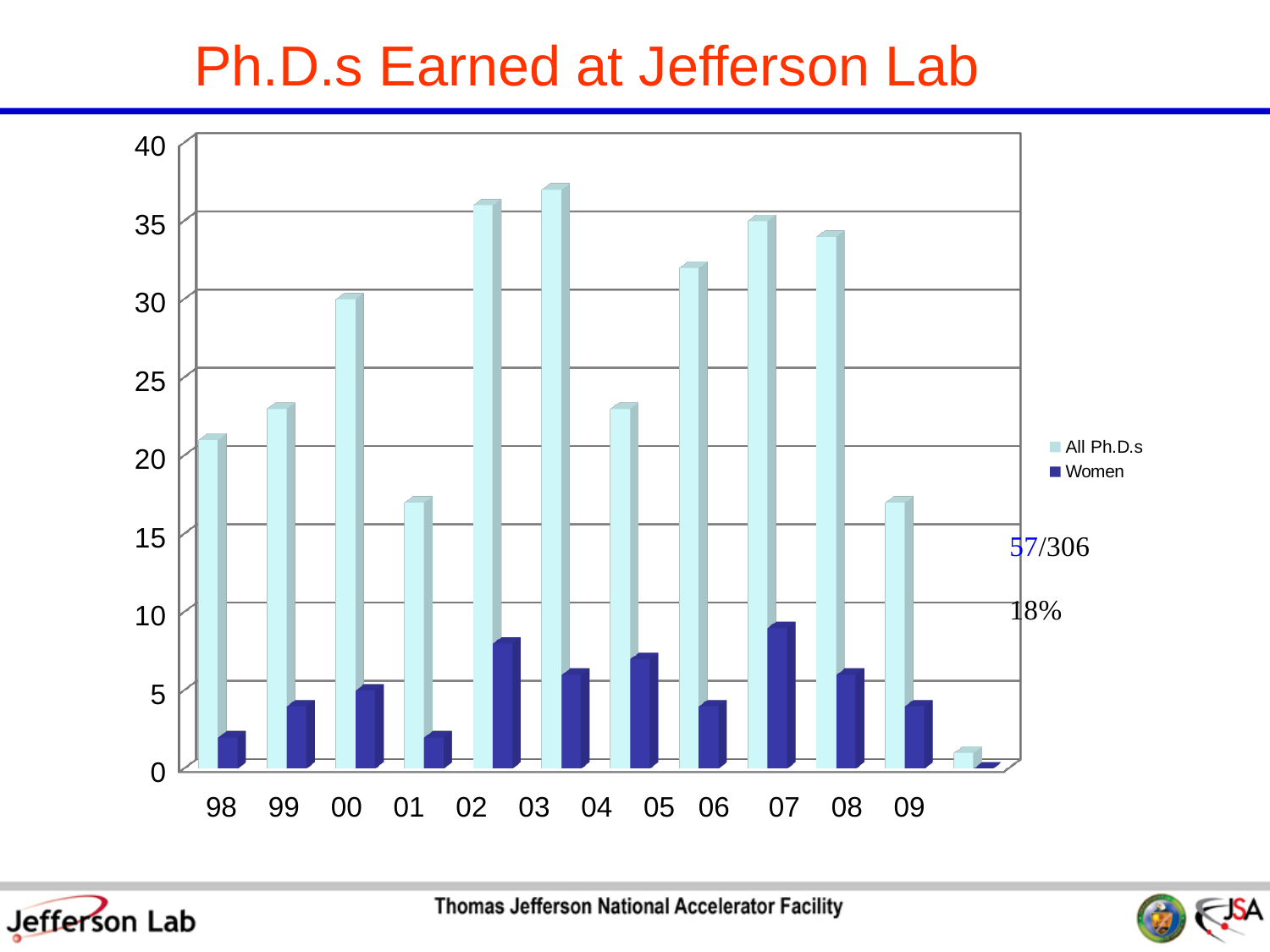
Is the All Ph.D.s value for 06 greater or less than 30? greater Is the Women value for 07 greater or less than 5? greater How many years are labeled on the x axis? 12 Is the All Ph.D.s value for 00 greater or less than 25? greater What are the two series named in the legend? All Ph.D.s and Women What is the title of the chart? Ph.D.s Earned at Jefferson Lab How many series does the legend list? 2 Which year has the higher All Ph.D.s value, 00 or 01? 00 Which year has the higher Women value, 02 or 01? 02 What kind of chart is shown on the slide? bar chart